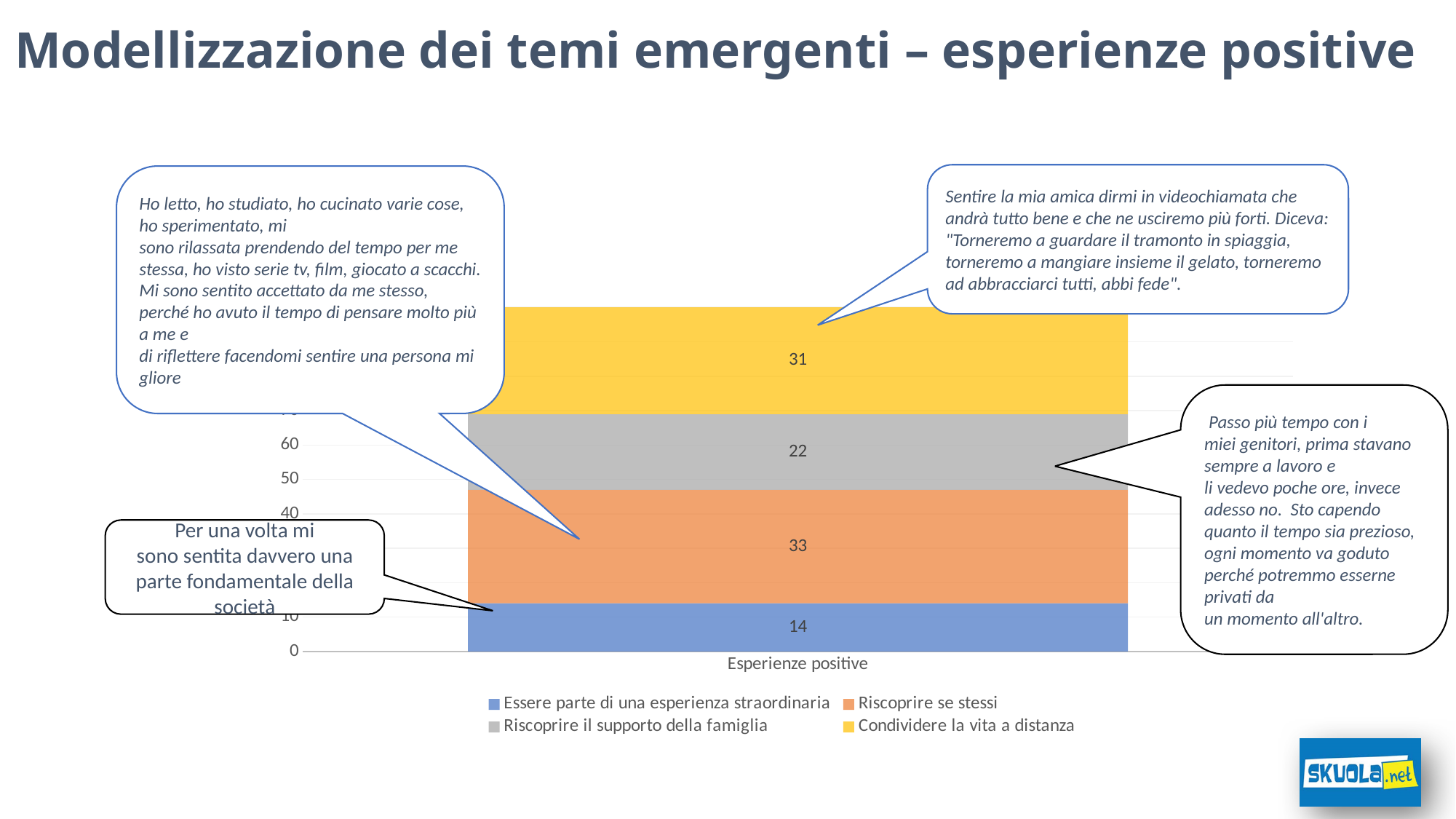
What value is shown for the series "Essere parte di una esperienza straordinaria"? 14 What is the total of the stacked bar for "Esperienze positive"? 100 What value is shown for the series "Riscoprire se stessi"? 33 What value is shown for the series "Condividere la vita a distanza"? 31 Which series has the lowest value in the stacked bar? Essere parte di una esperienza straordinaria What is the category label shown on the x axis of the chart? Esperienze positive Which is larger: the value for "Condividere la vita a distanza" or the value for "Riscoprire il supporto della famiglia"? Condividere la vita a distanza How many series does the legend list? 4 Which series has the highest value in the stacked bar? Riscoprire se stessi What value is shown for the series "Riscoprire il supporto della famiglia"? 22 What is the difference between the values for "Riscoprire se stessi" and "Riscoprire il supporto della famiglia"? 11 What kind of chart is shown on the slide? Stacked bar chart